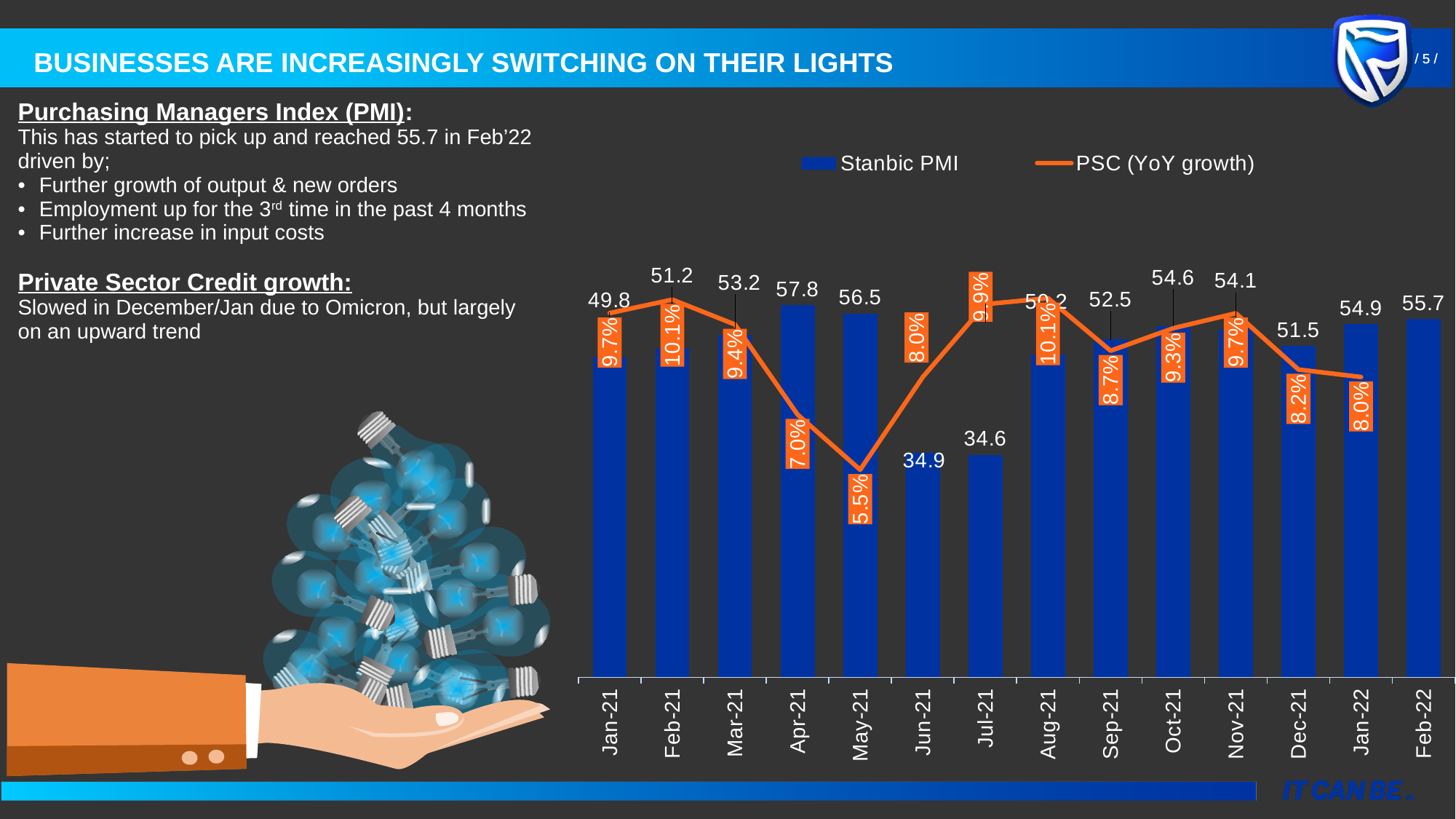
How many series does the legend list? 2 Which month has the lowest Stanbic PMI value? Jul-21 How many months are shown on the x axis? 14 Which is larger, the Stanbic PMI for Oct-21 or for Nov-21? Oct-21 What is the PSC (YoY growth) value for May-21? 5.5% Which month has the lowest PSC (YoY growth) value? May-21 What is the Stanbic PMI value for Feb-22? 55.7 Does the PSC (YoY growth) line rise or fall from Nov-21 to Jan-22? Fall Which month has the highest Stanbic PMI value? Apr-21 What is the Stanbic PMI value for Jun-21? 34.9 What kind of chart is shown on the slide? Combination bar and line chart What is the difference between the Stanbic PMI values for Apr-21 and May-21? 1.3